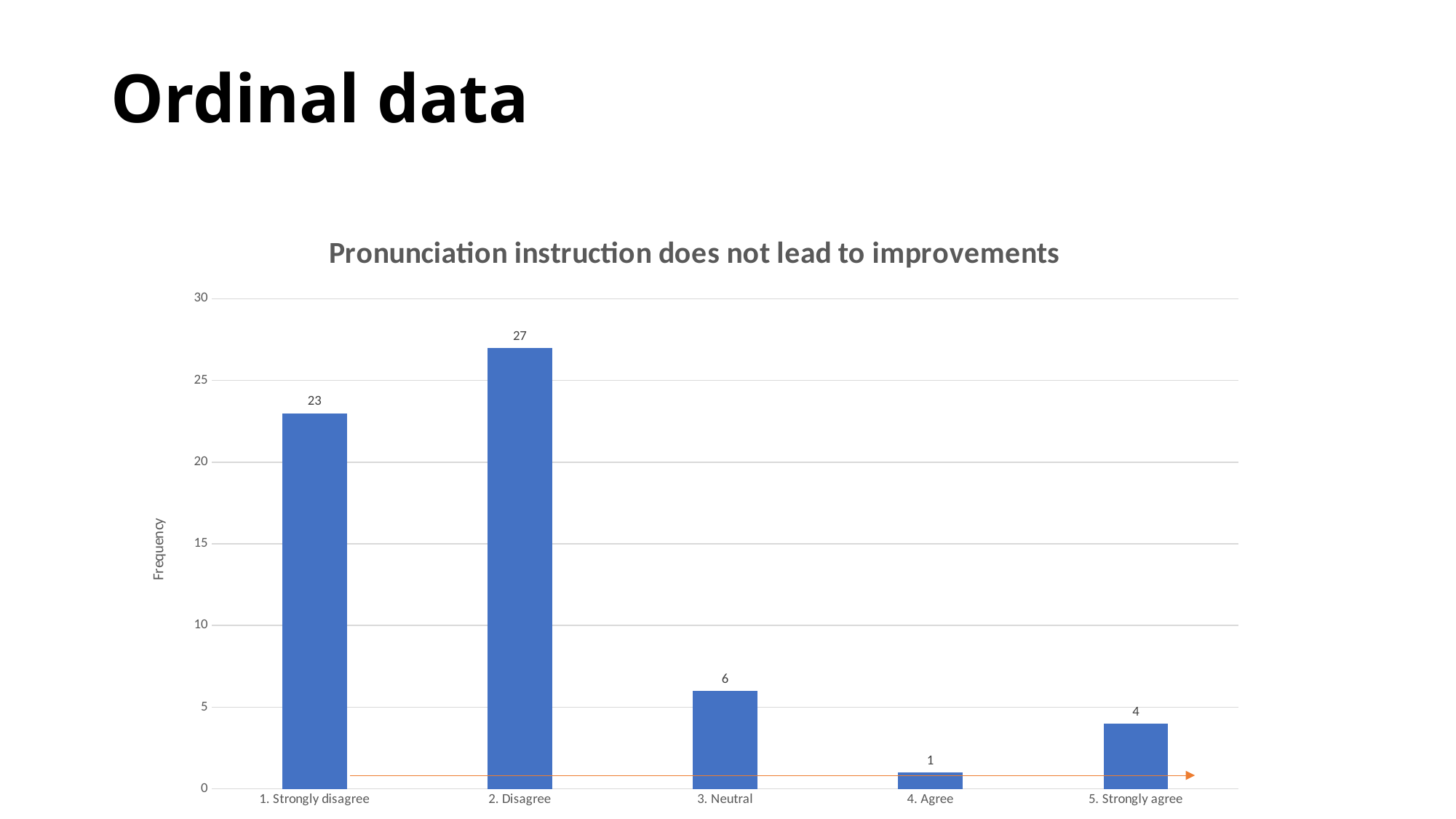
Which category has the lowest frequency? 4. Agree What is the frequency for '5. Strongly agree'? 4 How many categories are shown on the x axis? 5 Is the value for '1. Strongly disagree' greater or less than 20? greater What is the frequency for '1. Strongly disagree'? 23 What is the title of the chart? Pronunciation instruction does not lead to improvements What is the frequency for '3. Neutral'? 6 Which category has the highest frequency? 2. Disagree What kind of chart is shown on the slide? Bar chart What is the difference in frequency between '2. Disagree' and '1. Strongly disagree'? 4 What is the frequency for '2. Disagree'? 27 Which has a higher frequency, '3. Neutral' or '5. Strongly agree'? 3. Neutral